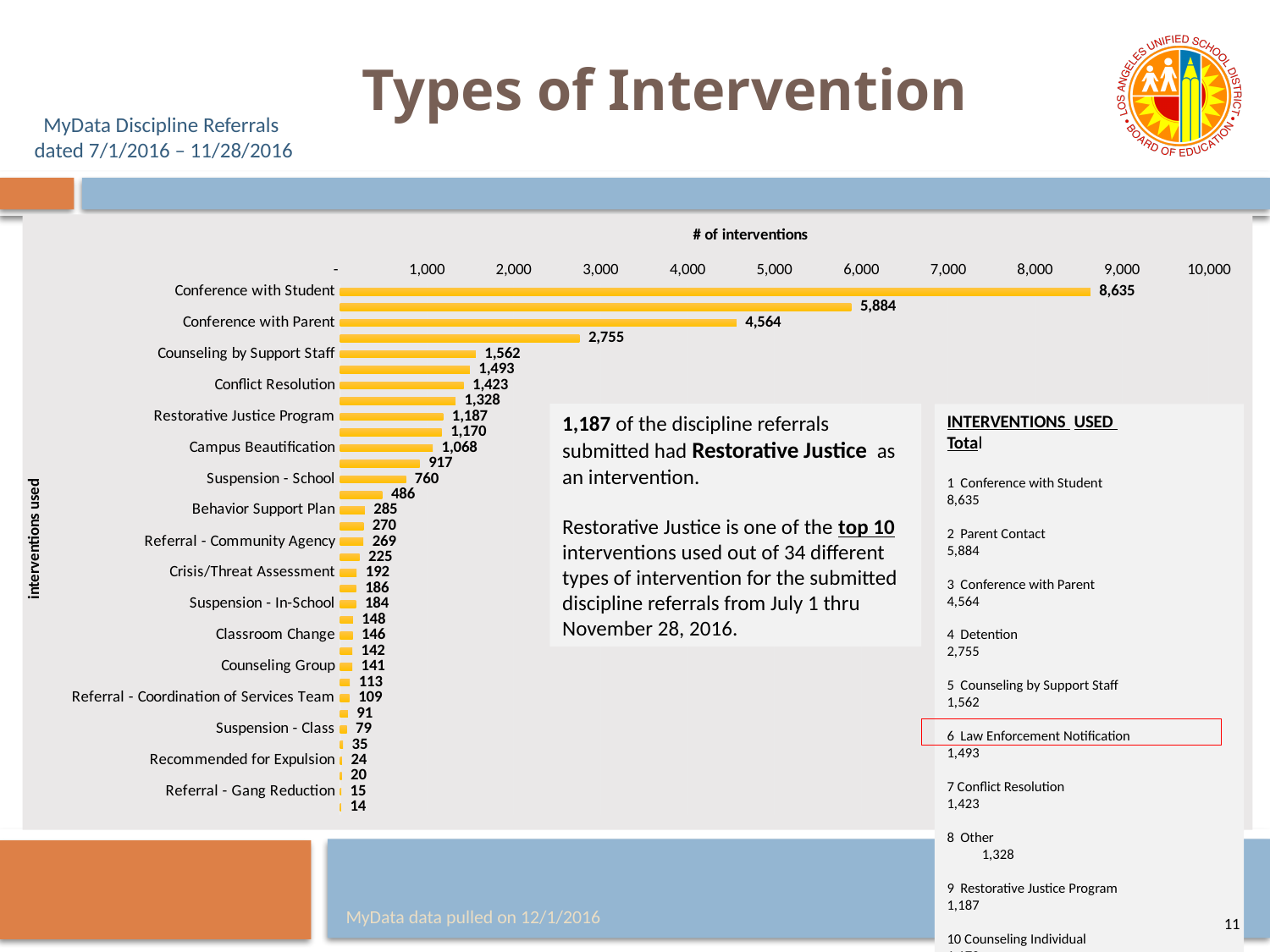
What is the title of the horizontal axis of the chart? # of interventions Is the value for Conference with Parent greater or less than 4,000? greater What is the number of interventions for Suspension - In-School? 184 What kind of chart is shown on the slide? Bar chart How many bars are plotted in the chart? 34 Which intervention type has the highest number of interventions? Conference with Student What is the difference between the number of interventions for Conference with Student and Conference with Parent? 4,071 What is the number of interventions for Referral - Gang Reduction? 15 What is the number of interventions for Campus Beautification? 1,068 What is the number of interventions for Restorative Justice Program? 1,187 What is the number of interventions for Conference with Student? 8,635 Which has more interventions, Conflict Resolution or Counseling by Support Staff? Counseling by Support Staff